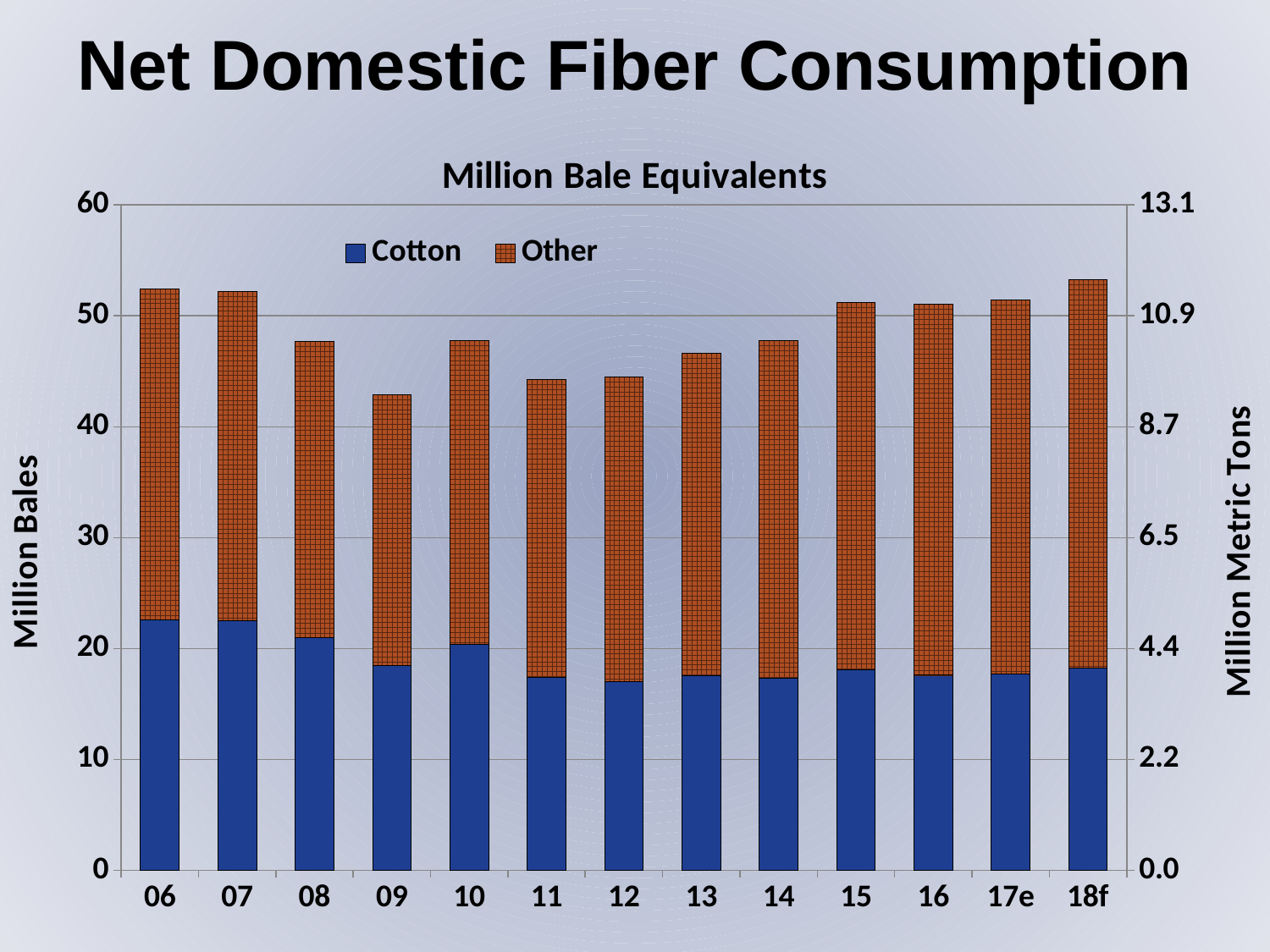
Which year has the lowest total net domestic fiber consumption? 09 Is the total bar for 18f greater or less than 50 million bales? greater Is the Cotton value for 12 greater or less than 20 million bales? less What kind of chart is shown on the slide? stacked bar chart Does the Cotton portion rise or fall from 06 to 09? fall Is the total bar for 09 greater or less than 50 million bales? less Which series is shown in blue? Cotton Which is larger, the total bar for 06 or the total bar for 09? 06 How many series does the legend list? 2 How many years (categories) are shown along the x axis? 13 What is the label on the left vertical axis? Million Bales